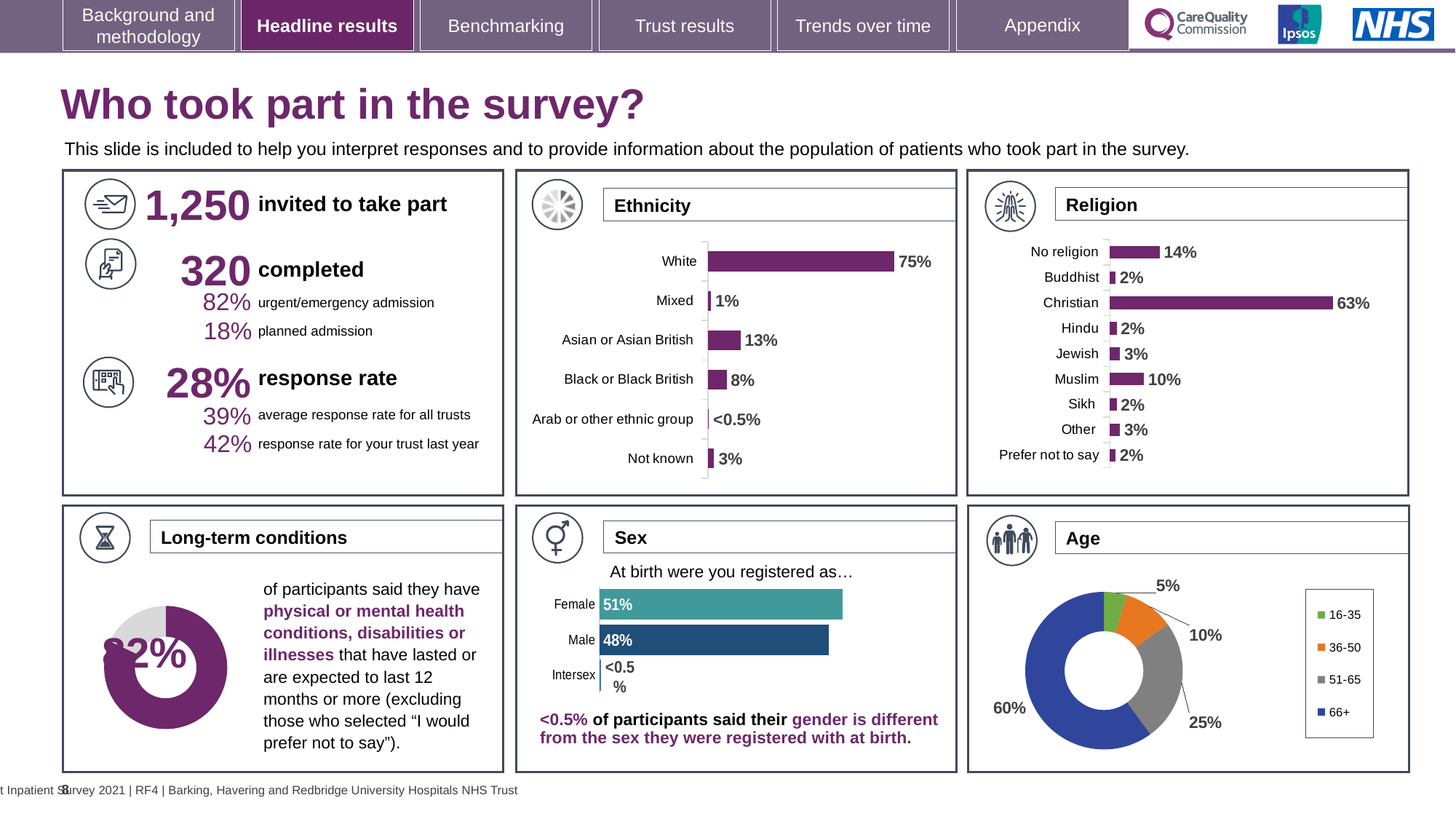
What type of chart is the Age chart? Donut chart In the Sex chart, what percentage of participants were registered as Male at birth? 48% In the Age chart, what share of participants were aged 66+? 60% In the Religion chart, which religion has the highest percentage? Christian In the Religion chart, what percentage of participants were Muslim? 10% In the Religion chart, which is larger: No religion or Muslim? No religion In the Ethnicity chart, which ethnic group has the lowest percentage? Arab or other ethnic group How many categories are shown in the Religion chart? 9 In the Ethnicity chart, what percentage of participants were White? 75% How many categories are shown in the Ethnicity chart? 6 In the Ethnicity chart, what is the difference between the Asian or Asian British and Black or Black British percentages? 5% In the Sex chart, what is the difference between the Female and Male percentages? 3%